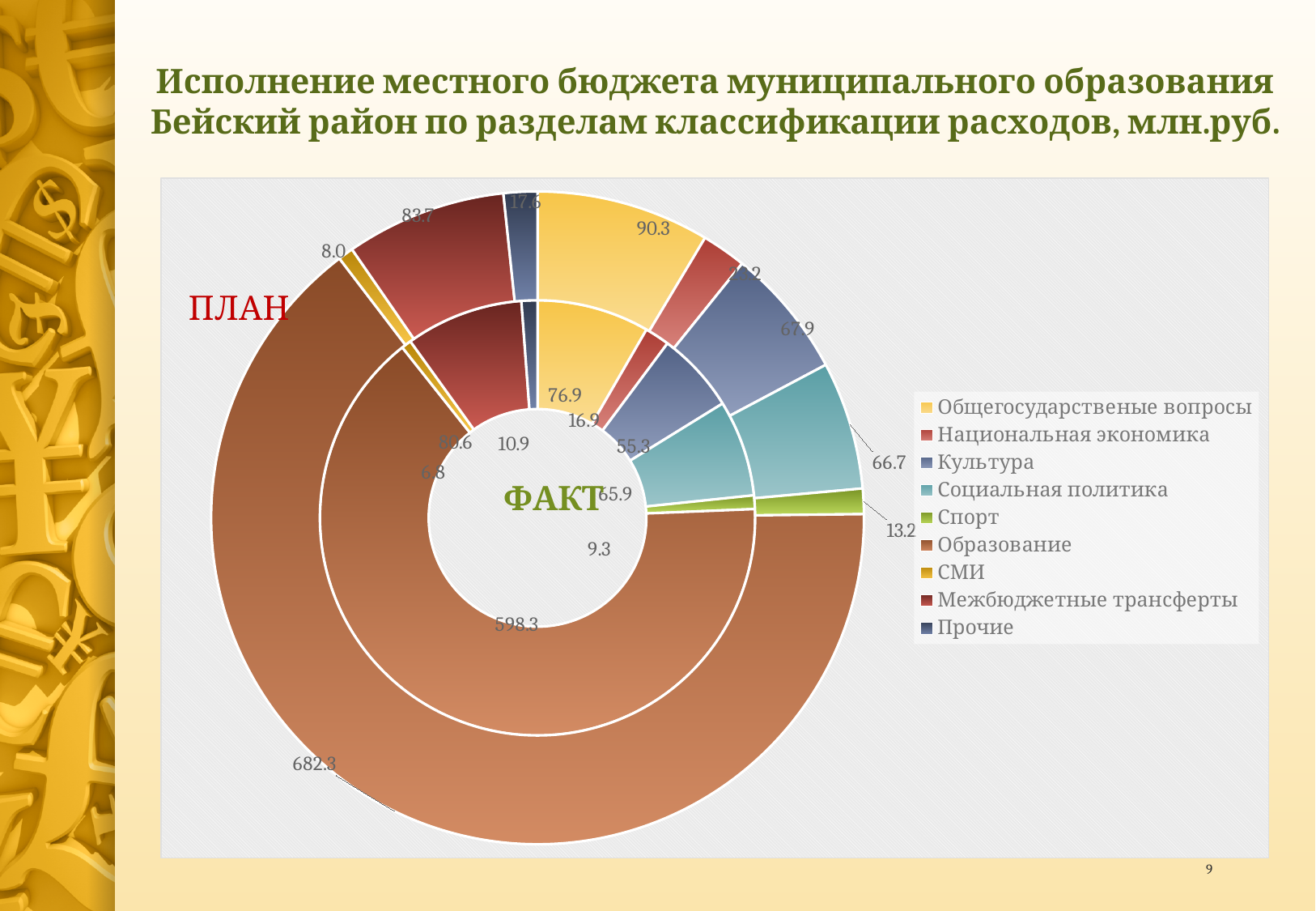
Which is larger, the ПЛАН value for Культура or the ПЛАН value for Социальная политика? Культура What is the ПЛАН value for Спорт? 13.2 What kind of chart is shown on the slide? doughnut chart Which category has the smallest ФАКТ value? СМИ What is the ФАКТ value for Культура? 55.3 What is the ФАКТ (inner ring) value for Образование? 598.3 What is the difference between the ПЛАН and ФАКТ values for Образование? 84.0 How many categories does the legend list? 9 Which category has the largest ПЛАН value? Образование What is the ПЛАН (outer ring) value for Образование? 682.3 Which ring of the chart represents ФАКТ, the inner or the outer? inner What is the ПЛАН value for Общегосударственые вопросы? 90.3